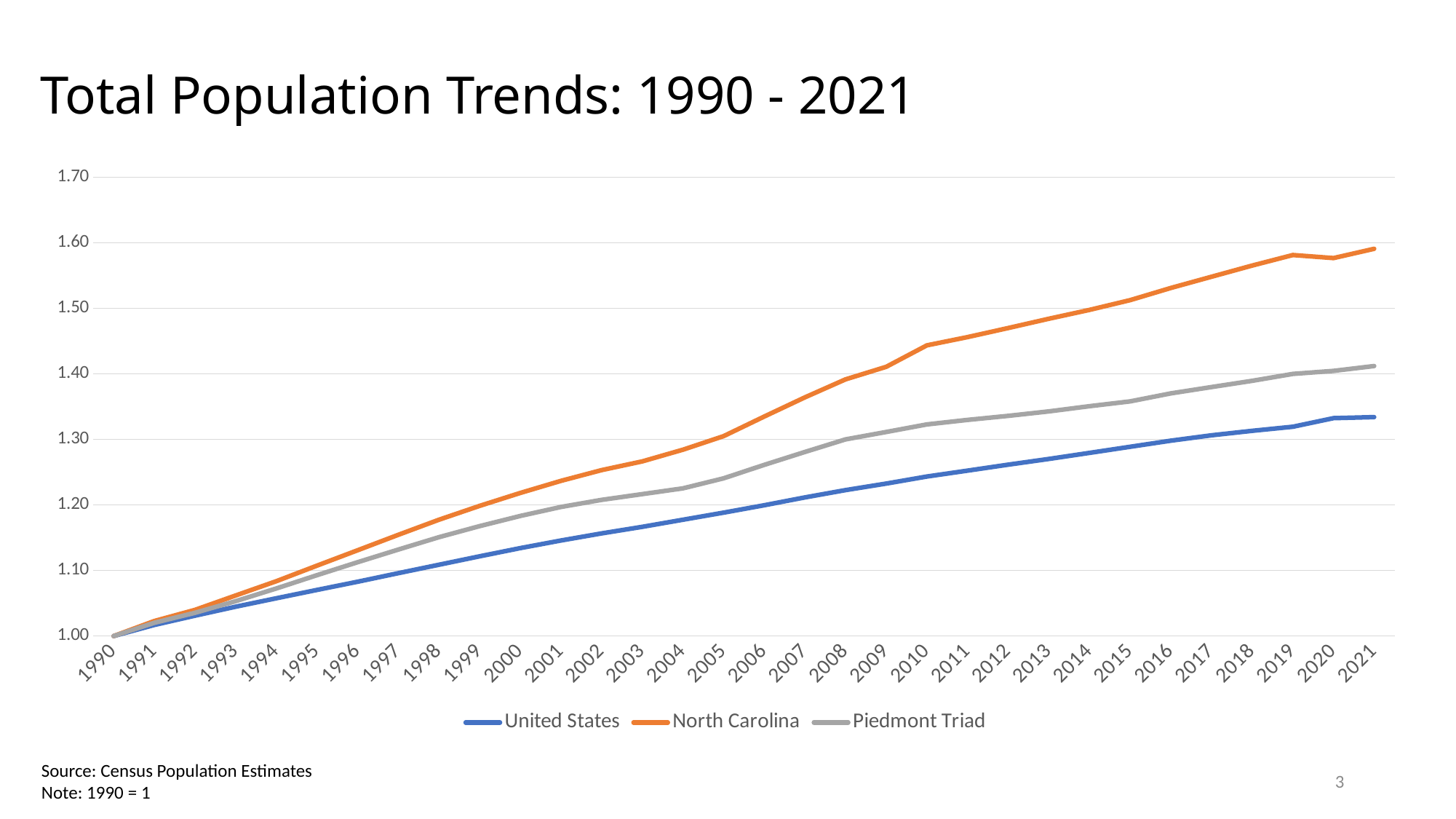
Is the value for United States in 2021 greater or less than 1.40? less Which series has the lowest value in 2021? United States Does the United States line rise or fall from 1990 to 2021? rise Which series has the highest value in 2021? North Carolina Is the value for Piedmont Triad in 2021 greater or less than 1.30? greater Is the value for North Carolina in 2021 greater or less than 1.50? greater What colour is the North Carolina line? Orange What is the value for United States in 1990? 1.00 How many series does the legend list? 3 How many years are plotted along the x axis? 32 What type of chart is shown on the slide? Line chart In 2010, which is larger: North Carolina or Piedmont Triad? North Carolina